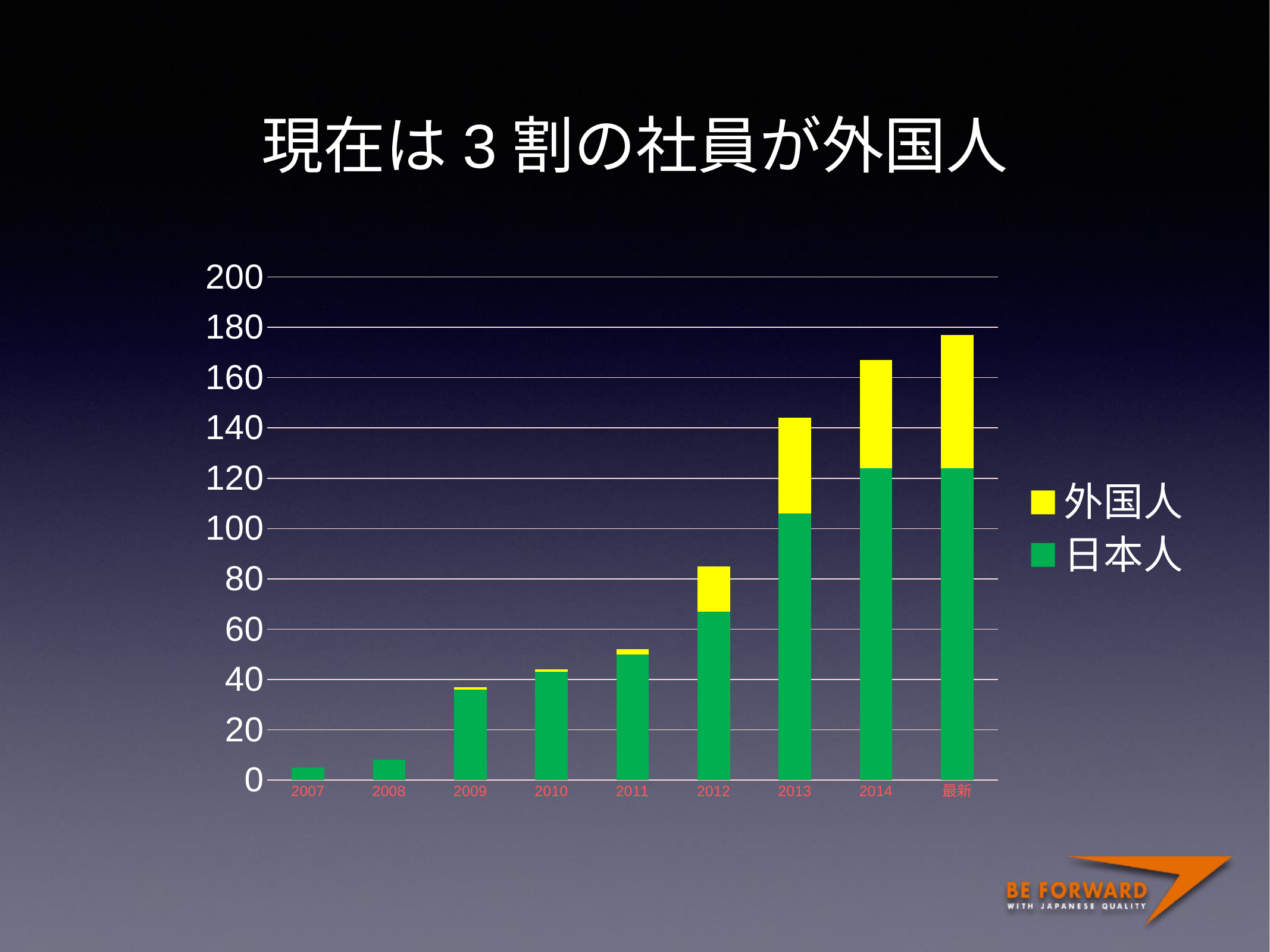
Is the total value for 2014 greater or less than 160? greater Which category has the highest total bar? 最新 Which category has the lowest total bar? 2007 Do the total bar heights rise or fall from 2007 to 最新? rise Is the total value for 最新 greater or less than 180? less Is the total value for 2007 greater or less than 20? less What is the title of the slide? 現在は３割の社員が外国人 How many categories are shown along the x axis? 9 How many series does the legend list? 2 Which series is shown in yellow? 外国人 What kind of chart is shown on the slide? stacked bar chart